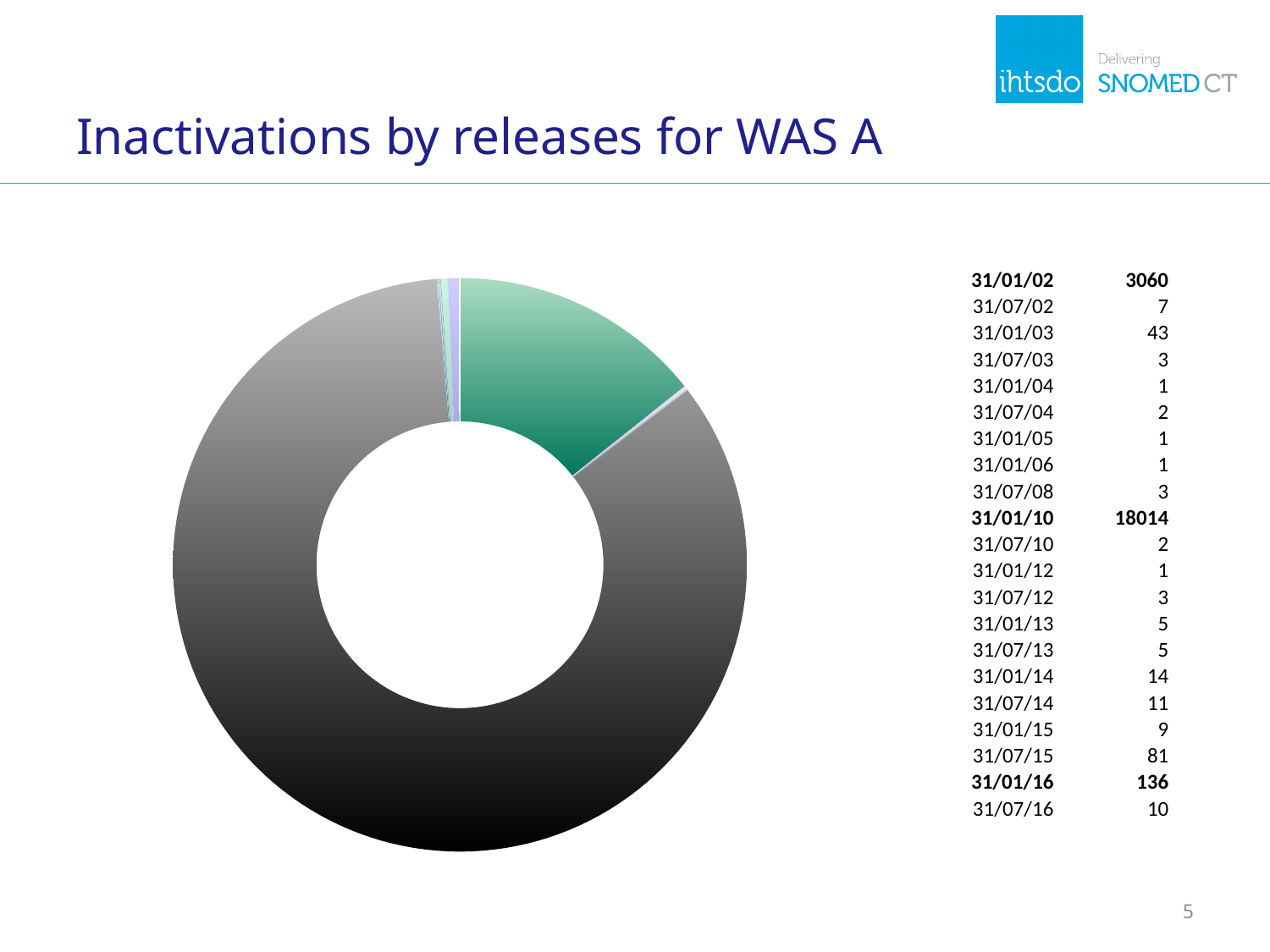
What is the title of the slide? Inactivations by releases for WAS A What is the difference between the values for 31/01/16 and 31/07/15? 55 What is the difference between the values for 31/01/10 and 31/01/02? 14954 How many releases are listed in the data table next to the chart? 21 What kind of chart is shown on the slide? Doughnut chart What is the value for the 31/07/15 release? 81 What is the value for the 31/01/03 release? 43 Which release has the highest number of inactivations? 31/01/10 What is the value for the 31/01/16 release? 136 Which is larger, the value for 31/01/02 or the value for 31/01/16? 31/01/02 What is the value for the 31/01/10 release? 18014 What is the value for the 31/01/02 release? 3060